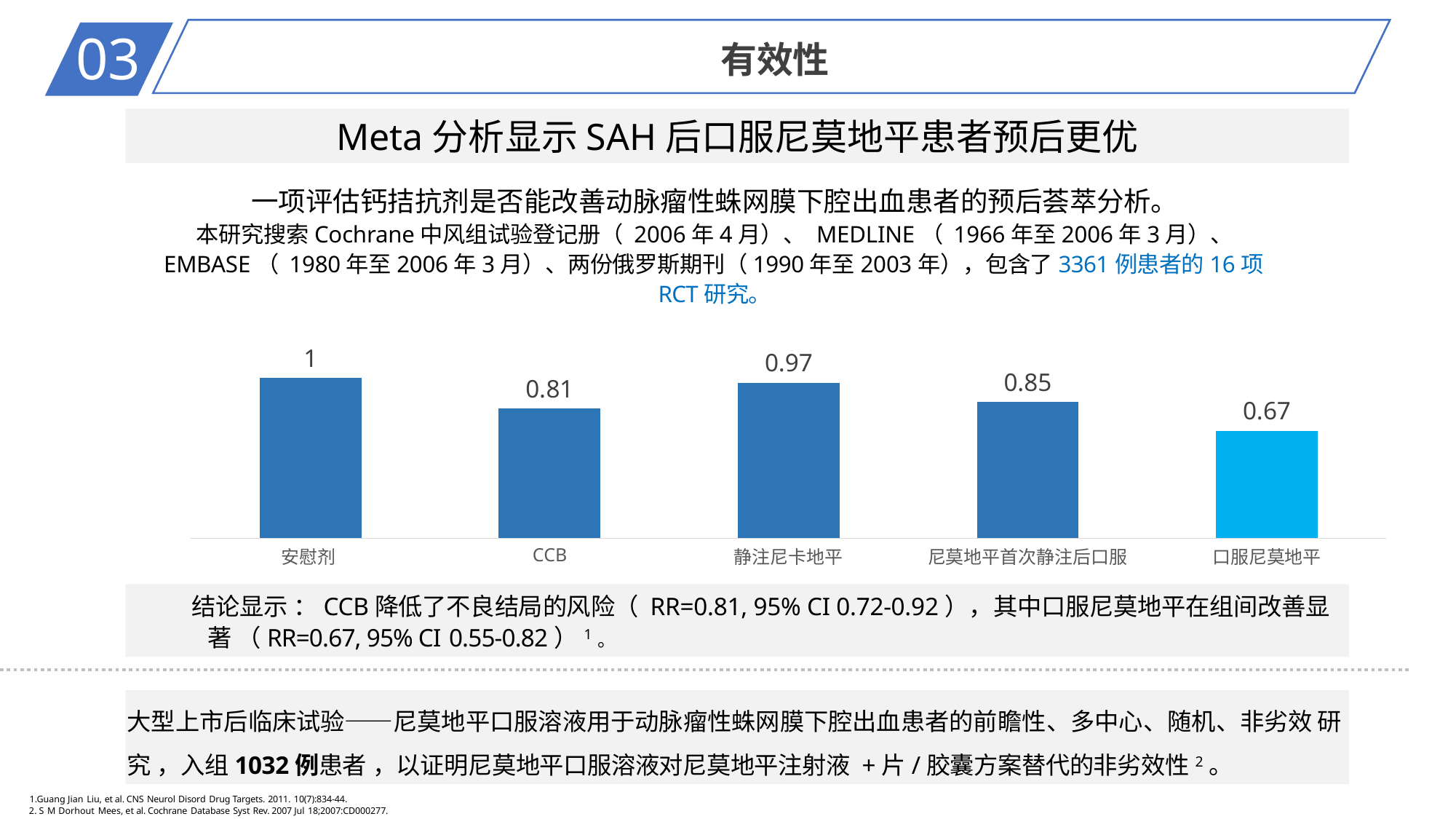
How many categories are shown in the chart? 5 What is the difference between the values for 静注尼卡地平 and CCB? 0.16 Which category has the highest value? 安慰剂 What is the value for 尼莫地平首次静注后口服? 0.85 Which is larger, the value for 尼莫地平首次静注后口服 or the value for CCB? 尼莫地平首次静注后口服 What is the value for 口服尼莫地平? 0.67 Which category has the lowest value? 口服尼莫地平 What is the difference between the values for 安慰剂 and 口服尼莫地平? 0.33 What kind of chart is shown on the slide? Bar chart What is the value for 静注尼卡地平? 0.97 What is the value for 安慰剂? 1 What is the value for CCB? 0.81